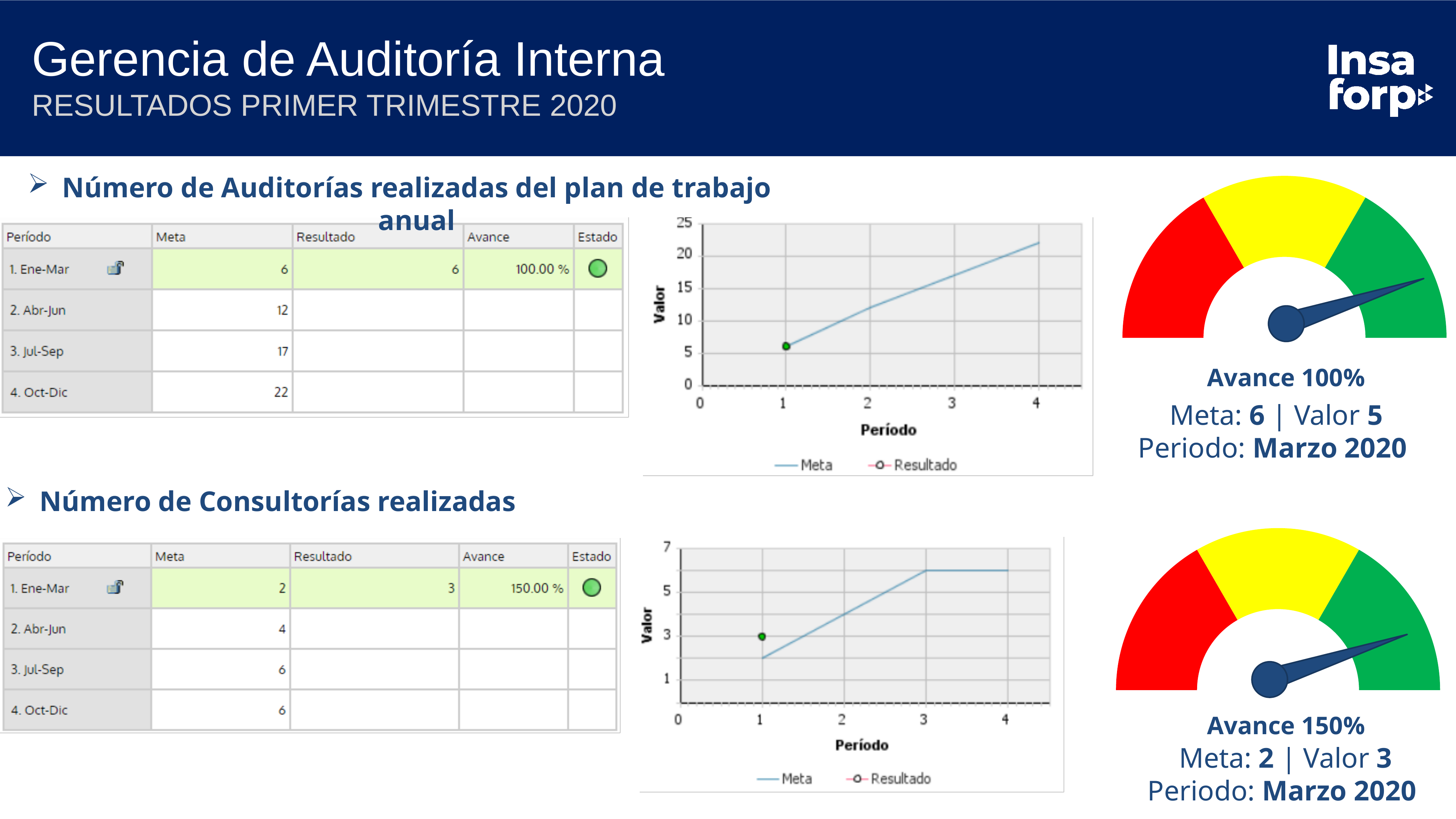
In the bottom chart, is the Meta value at period 1 greater or less than 3? less In the top chart, is the Meta value at period 4 greater or less than 20? greater In the bottom chart, is the Meta value at period 4 greater or less than 5? greater What kind of chart is the bottom chart next to the 'Número de Consultorías realizadas' table? Line chart What kind of chart is the top chart next to the 'Número de Auditorías realizadas del plan de trabajo anual' table? Line chart In the top chart, does the Meta line rise or fall from period 1 to period 4? Rises In the bottom chart, what is the Resultado value at period 1? 3 In the top chart, what are the two legend entries? Meta and Resultado In the top chart, how many series does the legend list? 2 In the bottom chart, what is the title of the x axis? Período In the top chart, what is the Meta value at period 4, as printed in the table beside it? 22